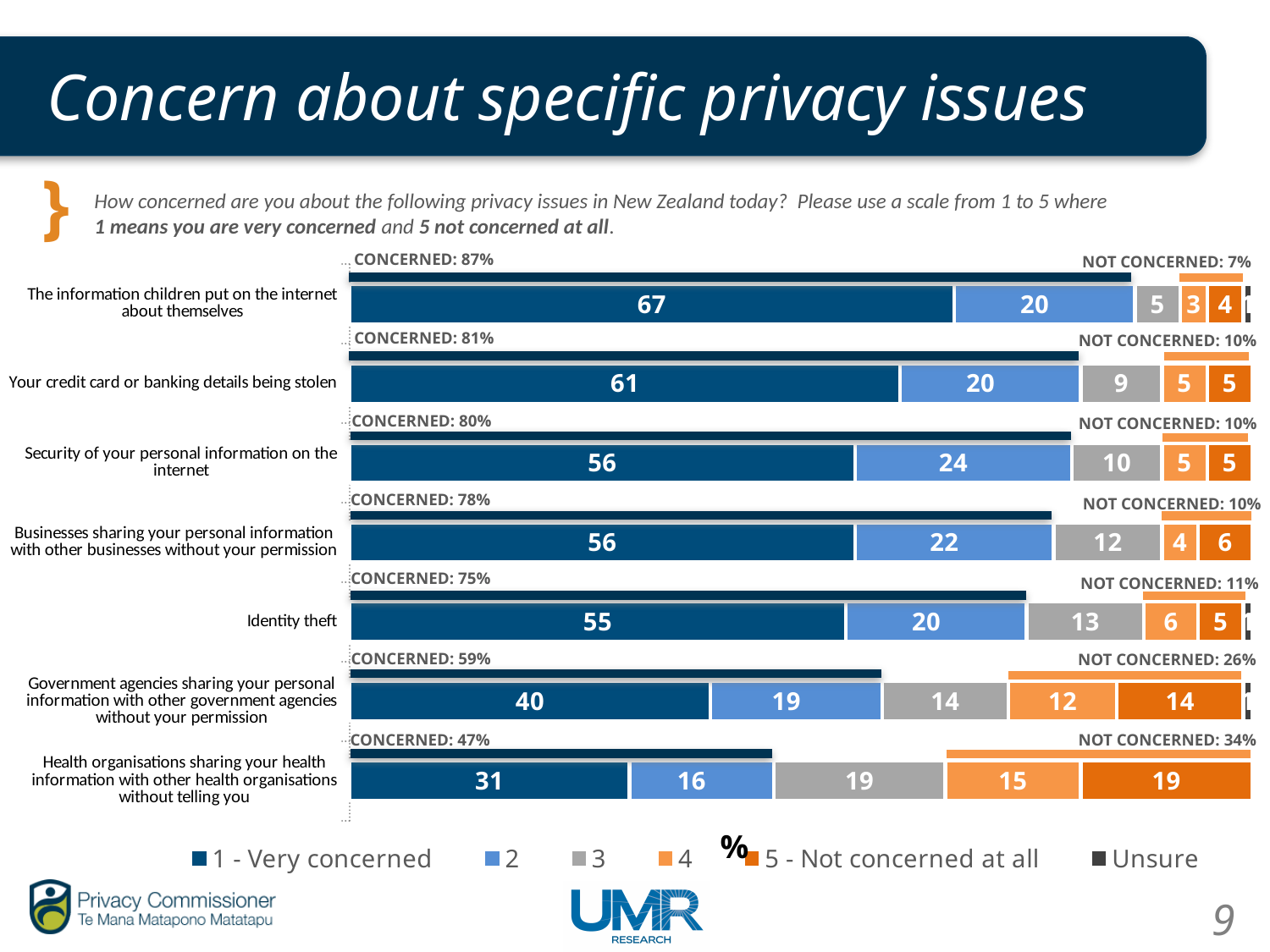
Which category has the lowest value for "1 - Very concerned"? Health organisations sharing your health information with other health organisations without telling you What is the value for "5 - Not concerned at all" for "Health organisations sharing your health information with other health organisations without telling you"? 19 What kind of chart is shown on the slide? Stacked bar chart What "CONCERNED" percentage is annotated above the bar for "Identity theft"? 75% How many categories (privacy issues) are shown in the chart? 7 What is the difference in the "1 - Very concerned" value between "The information children put on the internet about themselves" and "Your credit card or banking details being stolen"? 6 What is the value for series "3" for "Government agencies sharing your personal information with other government agencies without your permission"? 14 What is the value for "1 - Very concerned" for "Identity theft"? 55 Which has the larger value for series "4": "Government agencies sharing your personal information with other government agencies without your permission" or "Health organisations sharing your health information with other health organisations without telling you"? Health organisations sharing your health information with other health organisations without telling you What is the value for series "2" for "Security of your personal information on the internet"? 24 Which category has the highest value for "1 - Very concerned"? The information children put on the internet about themselves How many series does the legend list? 6